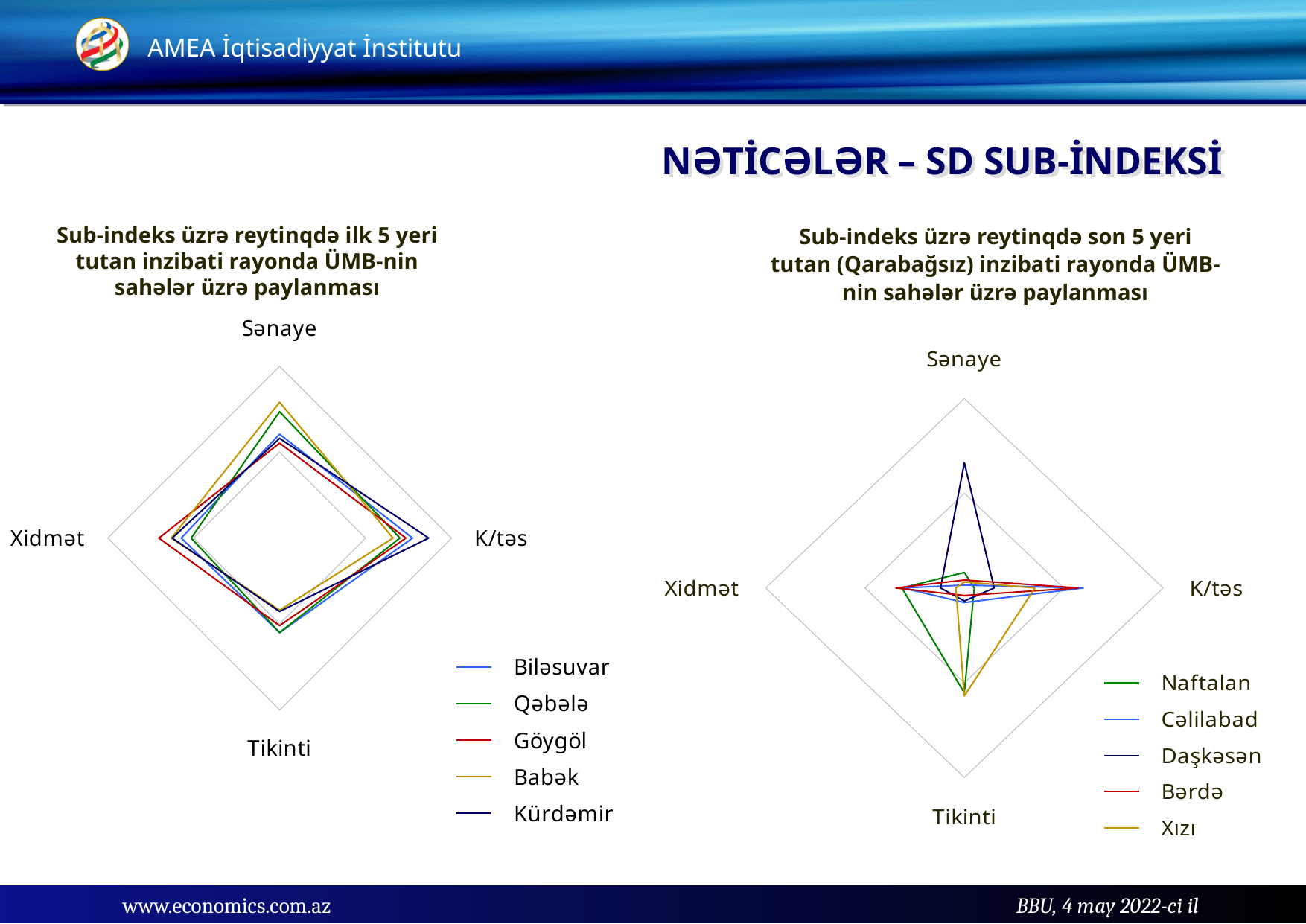
In the left chart, which district has the highest value on the Sənaye axis? Babək What kind of chart is the right chart, 'Sub-indeks üzrə reytinqdə son 5 yeri tutan (Qarabağsız) inzibati rayonda ÜMB-nin sahələr üzrə paylanması'? Radar chart How many axes (categories) does the left chart have? 4 How many series does the legend of the right chart list? 5 What kind of chart is the left chart, 'Sub-indeks üzrə reytinqdə ilk 5 yeri tutan inzibati rayonda ÜMB-nin sahələr üzrə paylanması'? Radar chart In the right chart, which district has the highest value on the Sənaye axis? Daşkəsən How many series does the legend of the left chart list? 5 In the left chart, which district has the highest value on the K/təs axis? Kürdəmir How many axes (categories) does the right chart have? 4 Which districts are listed in the legend of the right chart? Naftalan, Cəlilabad, Daşkəsən, Bərdə, Xızı